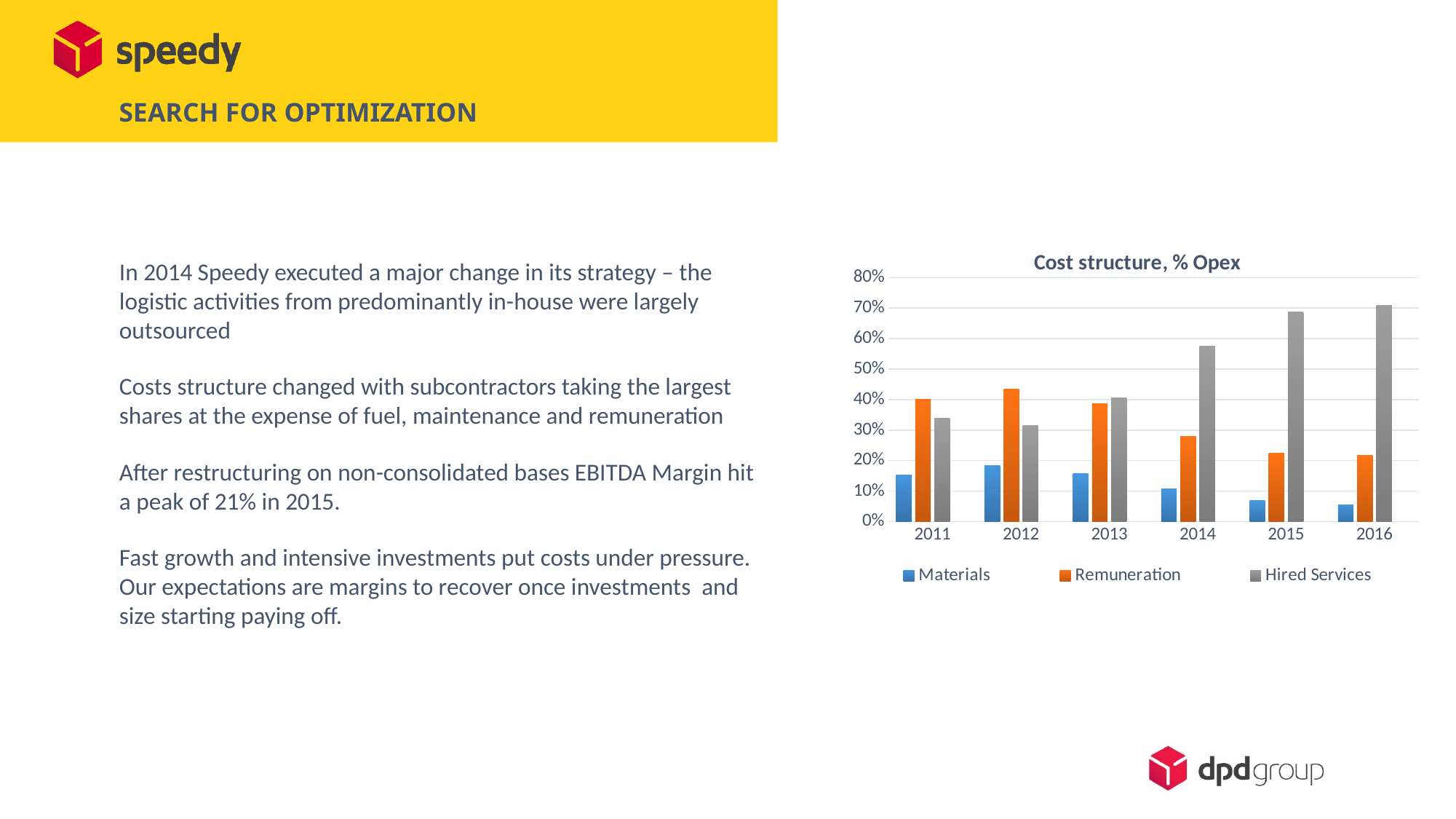
In 2011, which is larger: Remuneration or Hired Services? Remuneration Do the Hired Services values rise or fall from 2013 to 2016? Rise Is the value for Materials in 2015 greater or less than 10%? less How many years are shown on the x axis of the chart? 6 What is the title of the chart? Cost structure, % Opex How many series does the legend of the chart list? 3 Do the Materials values rise or fall from 2012 to 2016? Fall In which year is the Materials bar the lowest? 2016 Is the value for Hired Services in 2014 greater or less than 50%? greater In which year is the Hired Services bar the highest? 2016 Is the value for Remuneration in 2012 greater or less than 40%? greater What kind of chart is shown on the slide? Bar chart